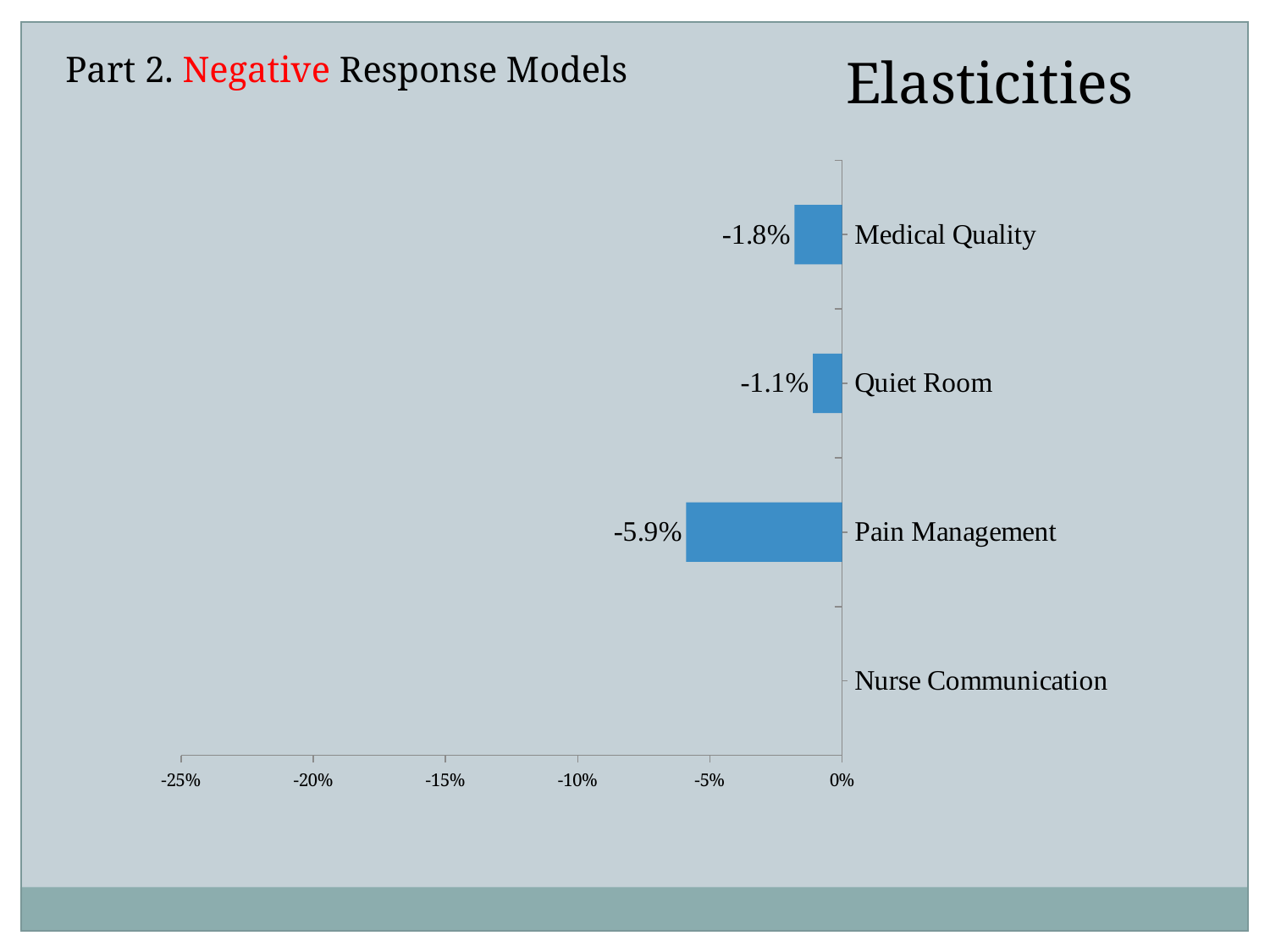
Which has a more negative value, Medical Quality or Quiet Room? Medical Quality What is the value shown for Pain Management? -5.9% What is the title of the chart? Elasticities What is the value shown for Quiet Room? -1.1% What is the difference between the values for Medical Quality and Quiet Room? 0.7 percentage points What is the value shown for Medical Quality? -1.8% Is the value for Pain Management greater or less than -5%? less How many categories are listed on the chart? 4 Among the categories with a labeled bar, which has the value closest to zero? Quiet Room What kind of chart is shown on the slide? Bar chart What is the difference between the values for Pain Management and Medical Quality? 4.1 percentage points